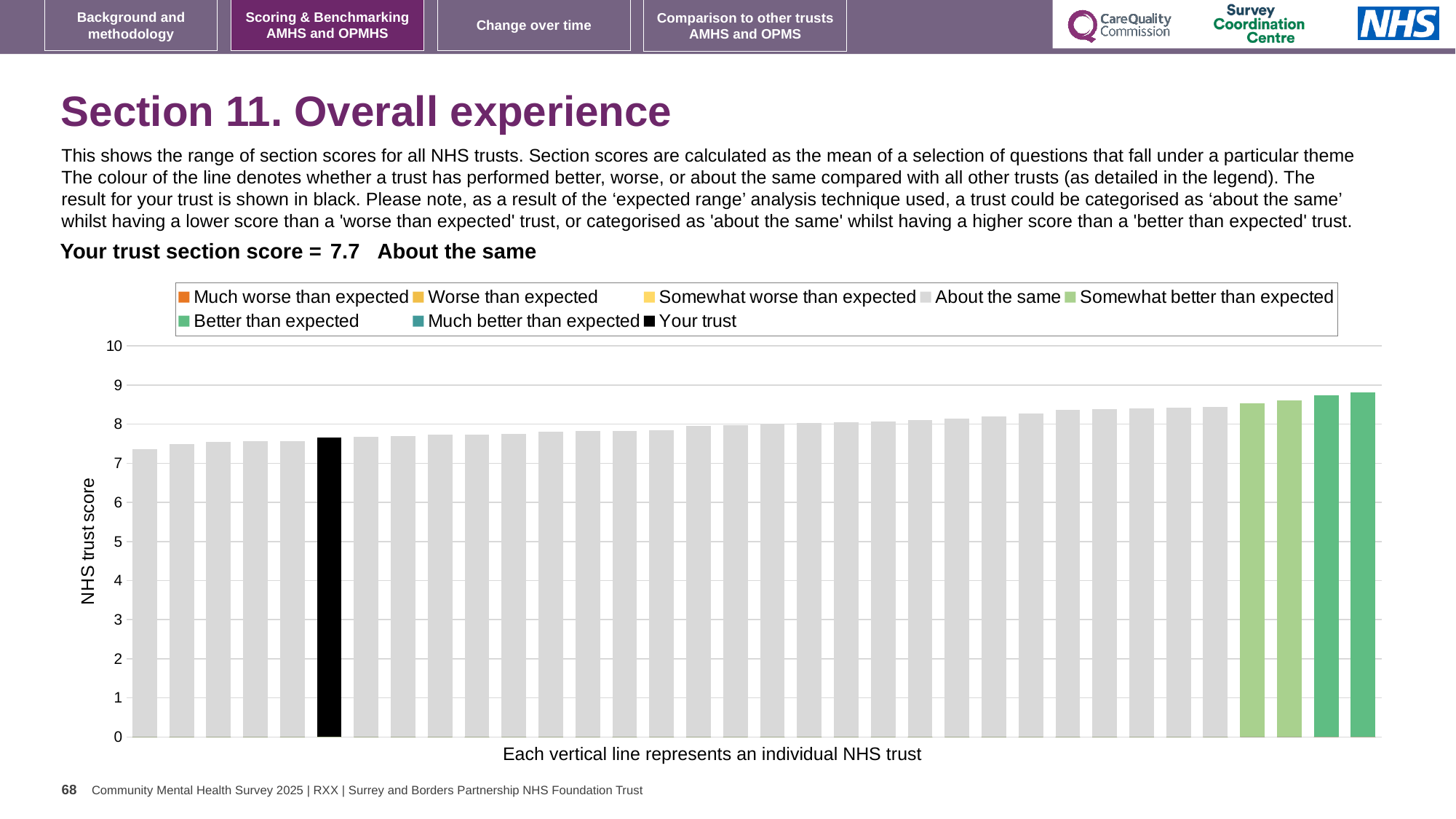
Is the value of the tallest bar greater or less than 9? less How many bars are coloured black to represent your trust? 1 Is the value for your trust (the black bar) greater or less than 8? less Is the value for your trust (the black bar) greater or less than 7? greater Do the bar values rise or fall from left to right along the x axis? rise What is the section score for your trust shown on the slide? 7.7 How many entries does the chart legend list? 8 Which benchmarking category is your trust placed in for Section 11? About the same What is the label on the vertical axis of the chart? NHS trust score What type of chart is shown on the slide? bar chart